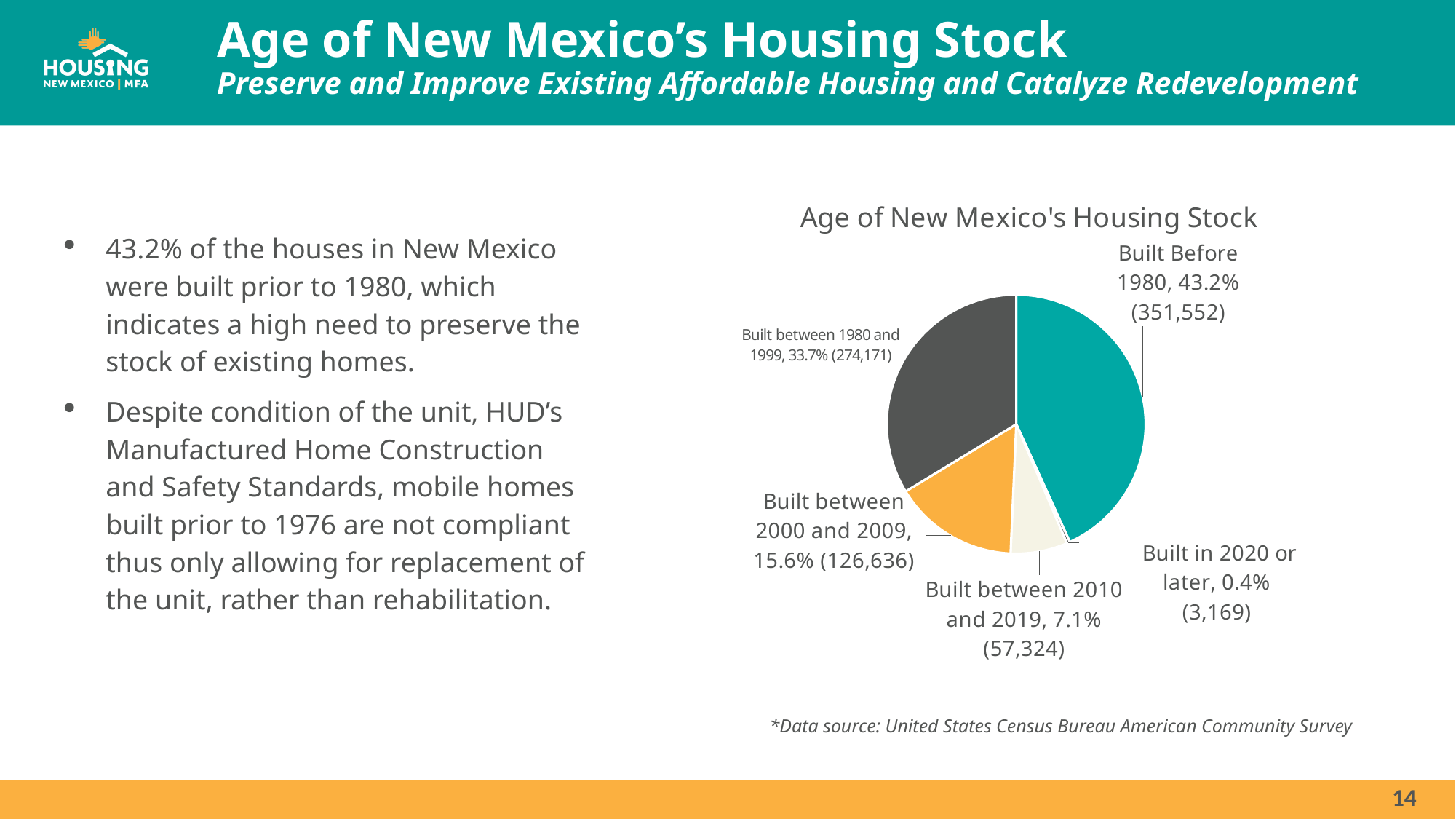
How many housing units were built between 2010 and 2019? 57,324 What kind of chart is shown on the slide? Pie chart What share of the housing stock was built between 2000 and 2009? 15.6% Which category has the largest slice of the pie? Built Before 1980 What colour is the Built Before 1980 slice? Teal How many slices does the pie chart have? 5 Which is larger: the number of units built between 2000 and 2009 or the number built between 2010 and 2019? Built between 2000 and 2009 How many housing units were built between 1980 and 1999? 274,171 What is the difference in percentage points between the Built Before 1980 slice and the Built between 1980 and 1999 slice? 9.5 What is the title of the chart? Age of New Mexico's Housing Stock Which category has the smallest slice of the pie? Built in 2020 or later What share of the housing stock was built before 1980? 43.2%